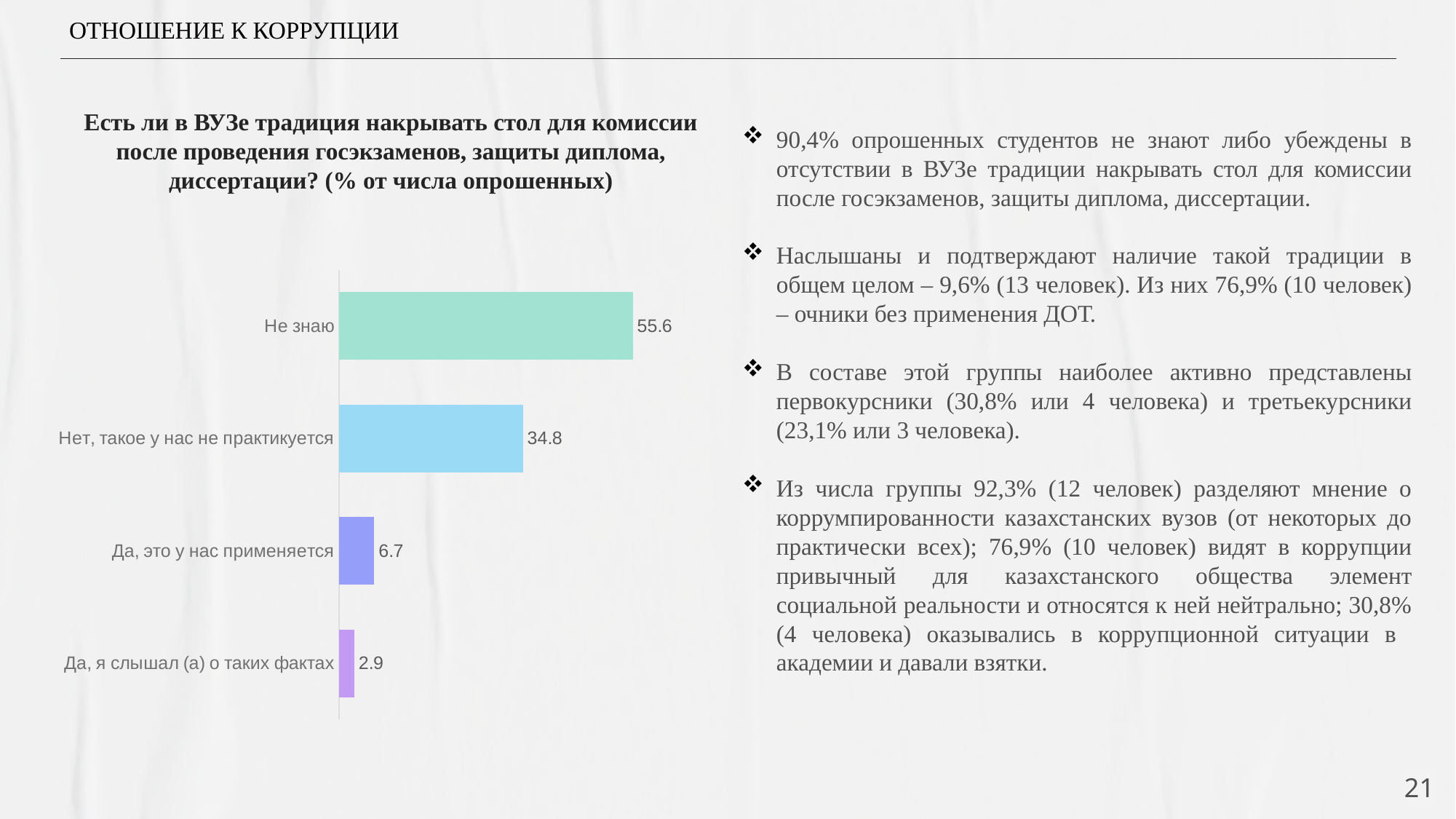
Which category has the highest value? Не знаю What is the value for "Нет, такое у нас не практикуется"? 34.8 What is the value for "Да, это у нас применяется"? 6.7 What colour is the bar for "Не знаю"? Green Which is larger: the value for "Нет, такое у нас не практикуется" or the value for "Да, это у нас применяется"? Нет, такое у нас не практикуется Which category has the lowest value? Да, я слышал (а) о таких фактах What is the difference between the values for "Да, это у нас применяется" and "Да, я слышал (а) о таких фактах"? 3.8 What is the value for "Да, я слышал (а) о таких фактах"? 2.9 What is the value for "Не знаю"? 55.6 How many categories are shown in the chart? 4 What is the difference between the values for "Не знаю" and "Нет, такое у нас не практикуется"? 20.8 What kind of chart is shown on the slide? Bar chart